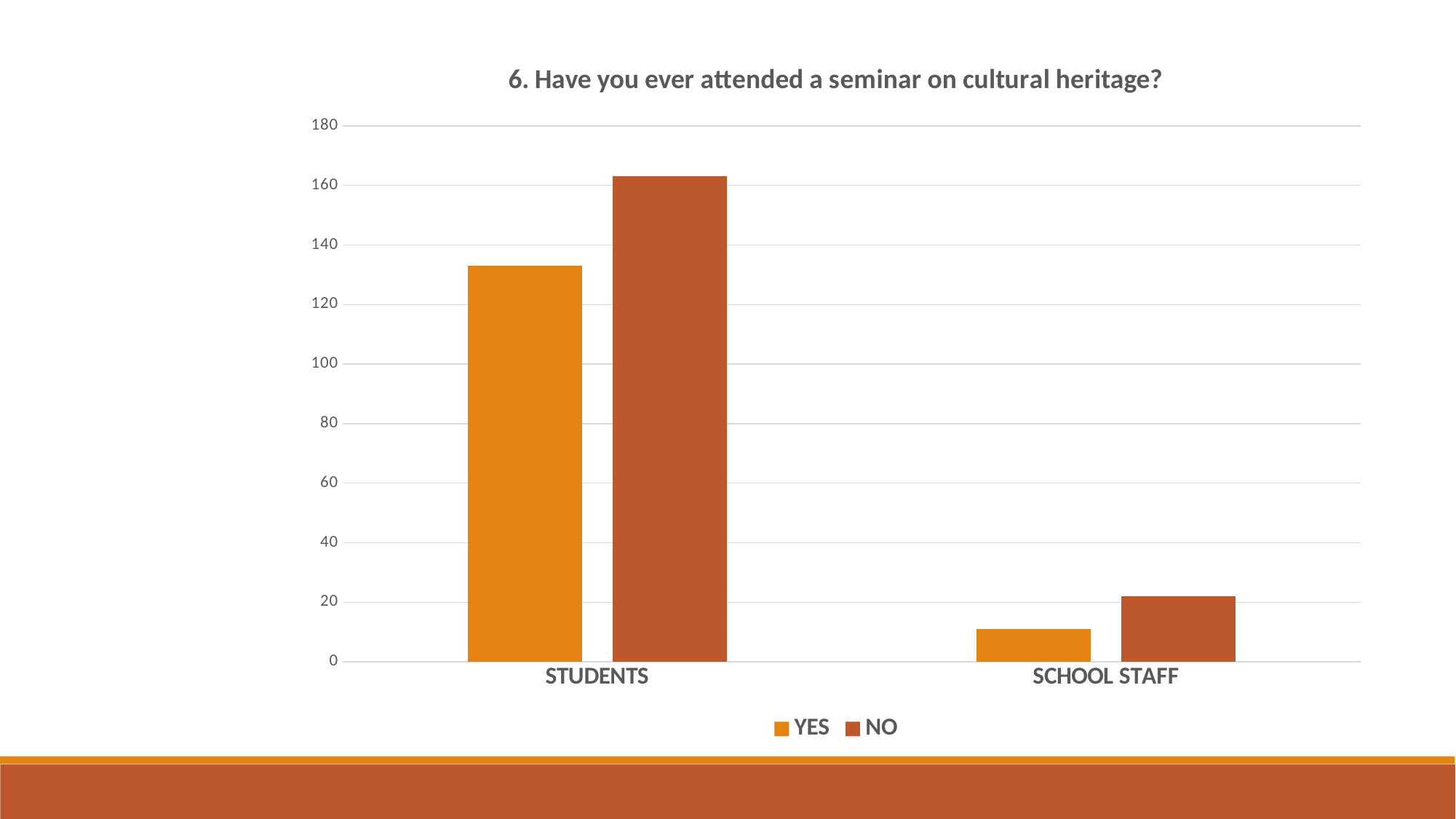
What kind of chart is shown on the slide? bar chart For STUDENTS, which is larger, YES or NO? NO Is the YES value for SCHOOL STAFF greater or less than 20? less What is the title of the chart? 6. Have you ever attended a seminar on cultural heritage? Which category has the highest NO value? STUDENTS Is the YES value for STUDENTS greater or less than 140? less How many series does the legend list? 2 How many categories are shown on the x axis? 2 For SCHOOL STAFF, which is larger, YES or NO? NO Which series are listed in the legend? YES and NO Which category has the lowest YES value? SCHOOL STAFF